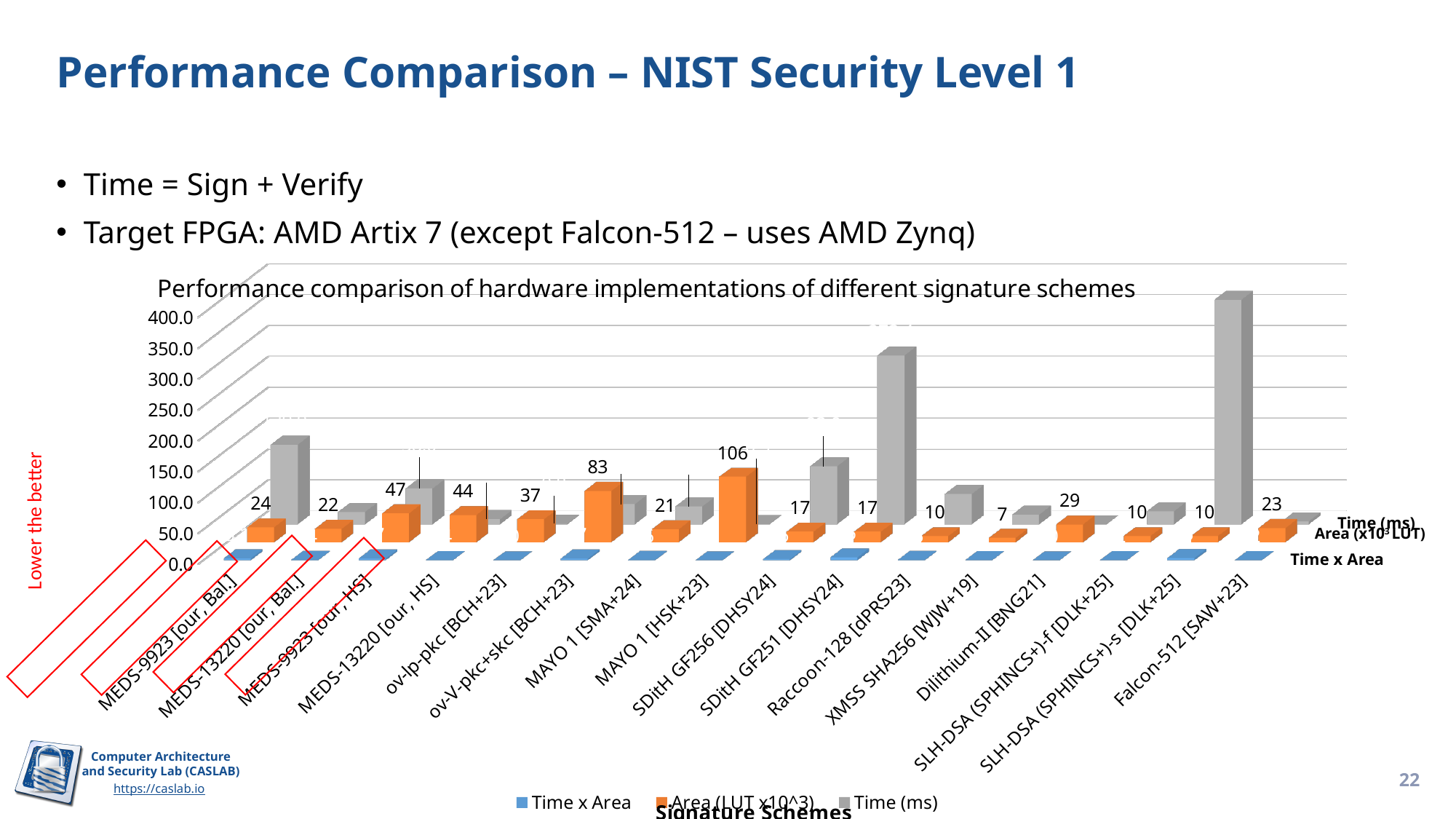
What is the Area (LUT x10^3) value for Falcon-512 [SAW+23]? 23 What kind of chart is shown on the slide? bar chart How many signature schemes are shown on the x axis of the chart? 16 What is the difference in Area (LUT x10^3) between MEDS-13220 [our, HS] and MEDS-13220 [our, Bal.]? 22 What is the difference in Area (LUT x10^3) between MAYO 1 [HSK+23] and MAYO 1 [SMA+24]? 85 Which signature scheme has the highest Area (LUT x10^3) value? MAYO 1 [HSK+23] Which has a larger Area (LUT x10^3) value, Dilithium-II [BNG21] or Raccoon-128 [dPRS23]? Dilithium-II [BNG21] How many series does the chart legend list? 3 What is the Area (LUT x10^3) value for MAYO 1 [HSK+23]? 106 What is the Area (LUT x10^3) value for MEDS-9923 [our, HS]? 47 Is the Time (ms) value for Falcon-512 [SAW+23] greater or less than 300? less Which signature scheme has the lowest Area (LUT x10^3) value? XMSS SHA256 [WJW+19]